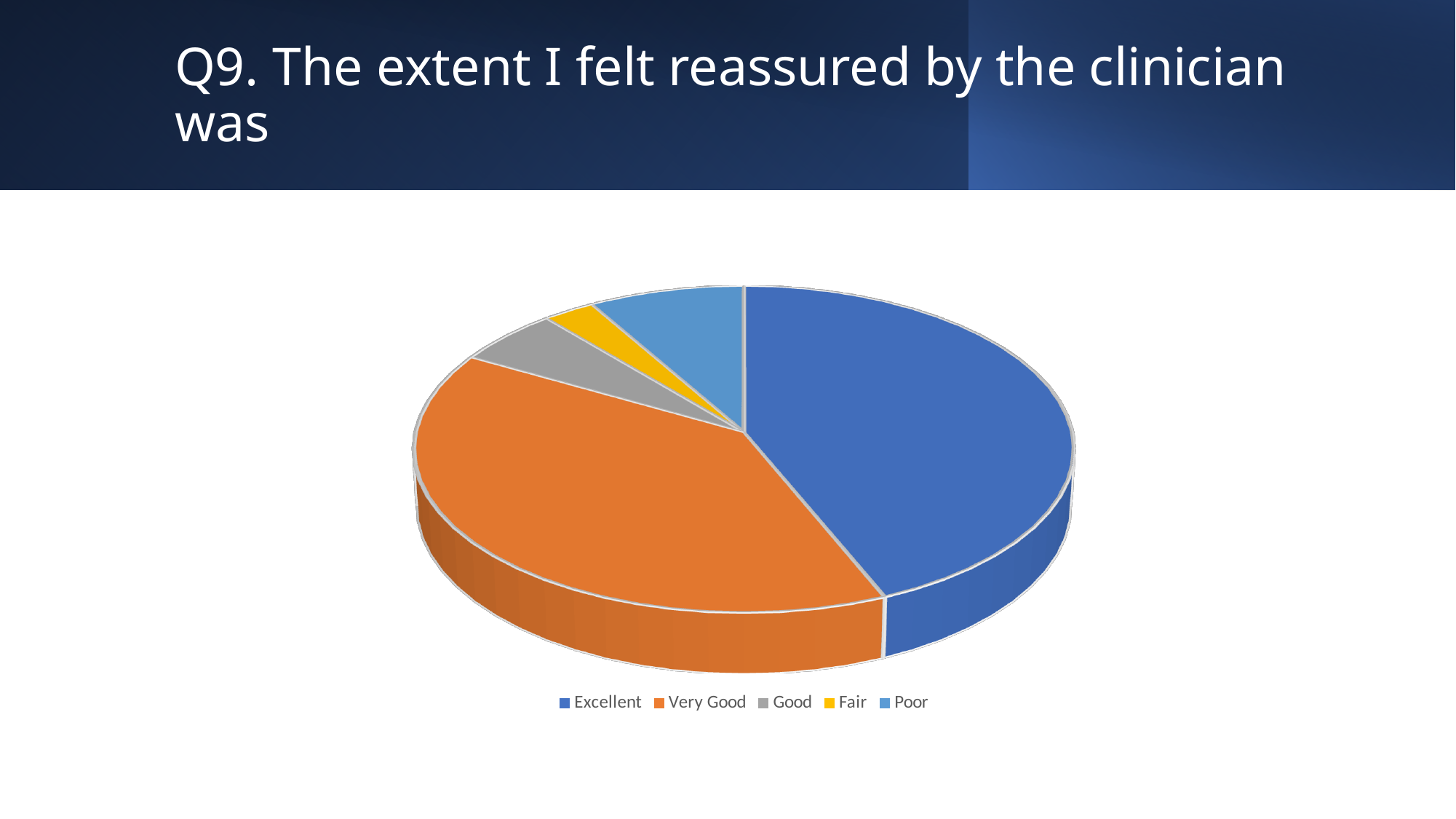
Which slice is larger, Poor or Good? Poor Which category has the smallest slice of the pie? Fair How many categories does the pie chart show? 5 Which slice is larger, Excellent or Poor? Excellent Which slice is larger, Very Good or Good? Very Good How many entries does the legend list? 5 What is the title of the slide containing the pie chart? Q9. The extent I felt reassured by the clinician was Which category is shown in orange in the pie chart? Very Good What kind of chart is shown on the slide? pie chart